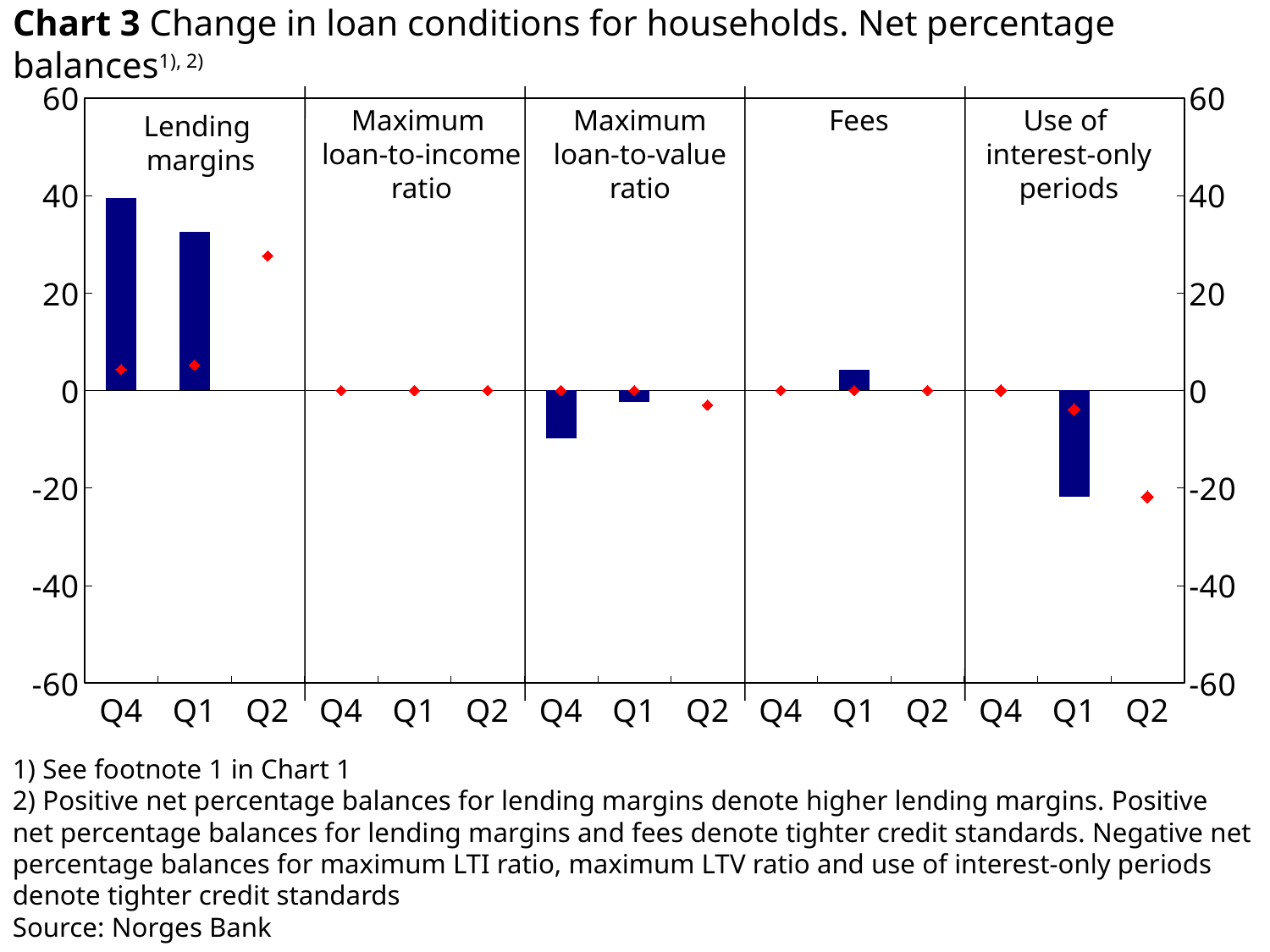
Is the Q1 bar for Use of interest-only periods greater or less than -40? greater What is the source given for Chart 3? Norges Bank Which panel contains the lowest (most negative) bar in Chart 3? Use of interest-only periods How many loan-condition panels does Chart 3 show? 5 Which panel contains the tallest positive bar in Chart 3? Lending margins Is the Q4 bar for Lending margins greater or less than 20? greater In the Lending margins panel, which bar is taller, Q4 or Q1? Q4 In the Maximum loan-to-value ratio panel, which bar is lower, Q4 or Q1? Q4 Is the Q1 bar for Fees greater or less than 20? less How many quarters are shown on the x axis within each panel of Chart 3? 3 What kind of chart is Chart 3? bar chart